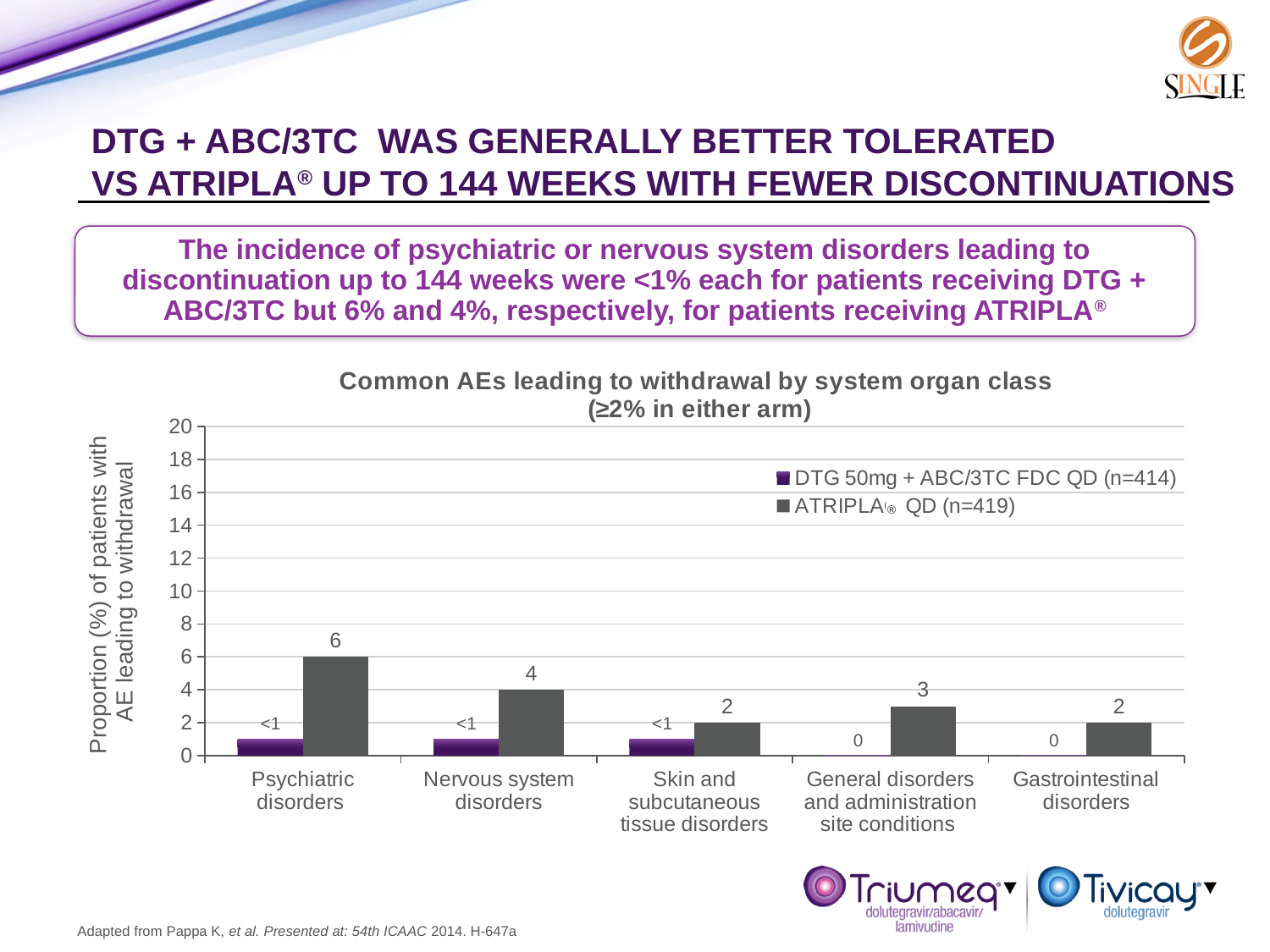
Which category has the highest value for ATRIPLA QD (n=419)? Psychiatric disorders How many system organ class categories are shown on the x axis? 5 What is the value for ATRIPLA QD (n=419) for Psychiatric disorders? 6 What is the value for ATRIPLA QD (n=419) for Nervous system disorders? 4 What type of chart is shown on the slide? Bar chart What is the value for DTG 50mg + ABC/3TC FDC QD (n=414) for General disorders and administration site conditions? 0 What is the title of the chart? Common AEs leading to withdrawal by system organ class (≥2% in either arm) How many series does the legend list? 2 Is the value for ATRIPLA QD (n=419) for Psychiatric disorders greater or less than 10? less What is the value for DTG 50mg + ABC/3TC FDC QD (n=414) for Psychiatric disorders? <1 For General disorders and administration site conditions, which series has the larger value? ATRIPLA QD (n=419) What is the difference between the ATRIPLA QD (n=419) values for Psychiatric disorders and Nervous system disorders? 2